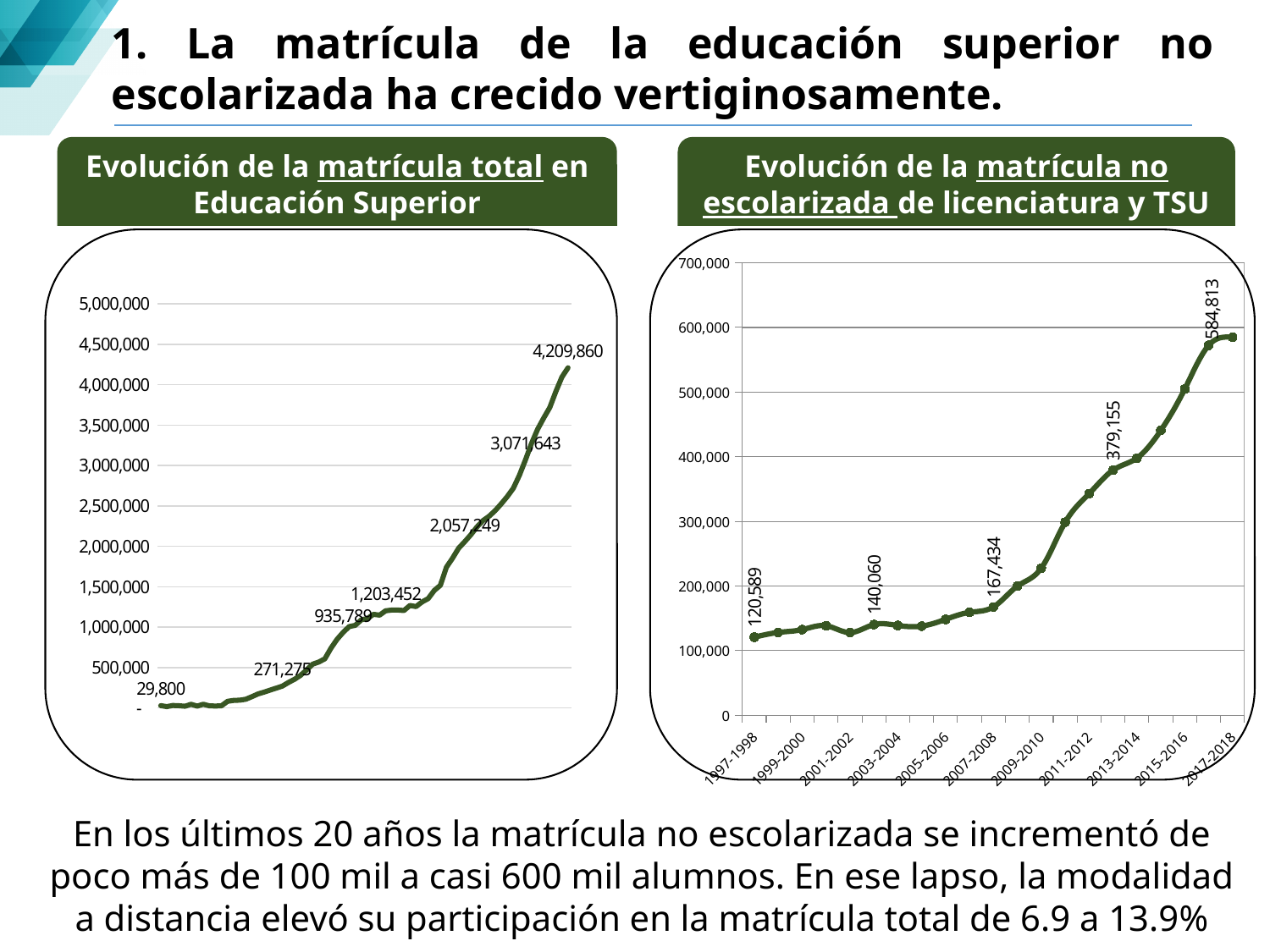
In the 'Evolución de la matrícula total en Educación Superior' chart, what is the highest labelled value? 4,209,860 In the 'Evolución de la matrícula no escolarizada de licenciatura y TSU' chart, what is the difference between the 2017-2018 value and the 1997-1998 value? 464,224 In the 'Evolución de la matrícula total en Educación Superior' chart, what is the lowest labelled value? 29,800 What kind of chart is the 'Evolución de la matrícula no escolarizada de licenciatura y TSU' chart? line chart In the 'Evolución de la matrícula no escolarizada de licenciatura y TSU' chart, which year has the highest value? 2017-2018 In the 'Evolución de la matrícula no escolarizada de licenciatura y TSU' chart, what is the value for 2017-2018? 584,813 In the 'Evolución de la matrícula no escolarizada de licenciatura y TSU' chart, do values generally rise or fall from 2007-2008 to 2017-2018? rise In the 'Evolución de la matrícula no escolarizada de licenciatura y TSU' chart, what is the value for 1997-1998? 120,589 In the 'Evolución de la matrícula no escolarizada de licenciatura y TSU' chart, what is the value for 2007-2008? 167,434 In the 'Evolución de la matrícula total en Educación Superior' chart, what is the difference between the labelled values 3,071,643 and 2,057,249? 1,014,394 In the 'Evolución de la matrícula no escolarizada de licenciatura y TSU' chart, is the value for 2009-2010 greater or less than 200,000? greater